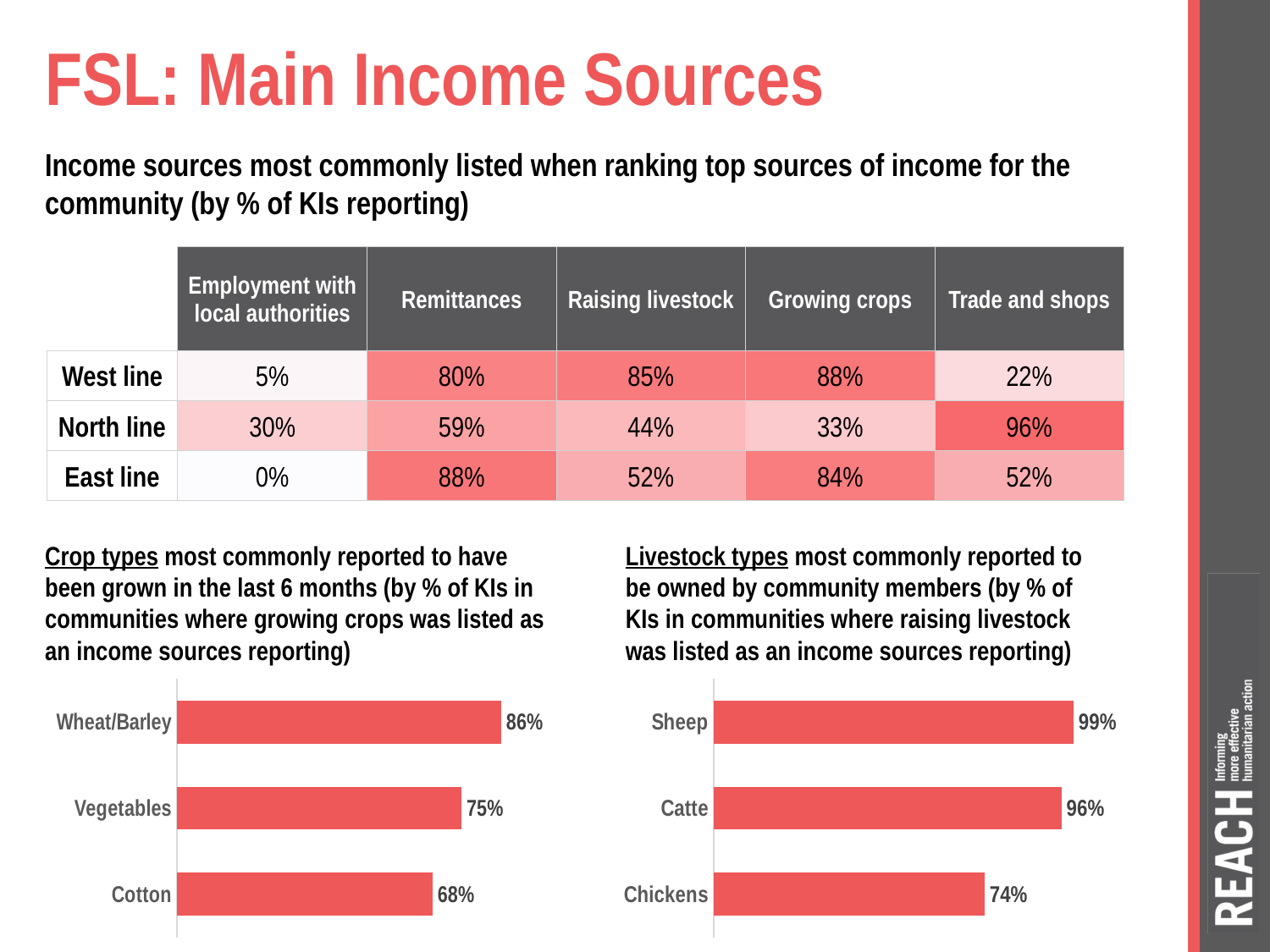
In the crop types chart on the left, which is larger: the value for Vegetables or the value for Cotton? Vegetables In the livestock types chart on the right, what percentage is shown for Sheep? 99% In the livestock types chart on the right, what is the label of the category with the value 96%? Catte What kind of chart is the crop types chart on the left? Bar chart In the crop types chart on the left, what percentage is shown for Cotton? 68% In the livestock types chart on the right, what percentage is shown for Chickens? 74% In the crop types chart on the left, what percentage is shown for Wheat/Barley? 86% In the livestock types chart on the right, what is the difference between the percentages for Sheep and Chickens? 25% In the crop types chart on the left, which crop type has the highest percentage? Wheat/Barley How many categories are shown in the livestock types chart on the right? 3 In the livestock types chart on the right, which livestock type has the lowest percentage? Chickens In the crop types chart on the left, what is the difference between the percentages for Wheat/Barley and Vegetables? 11%